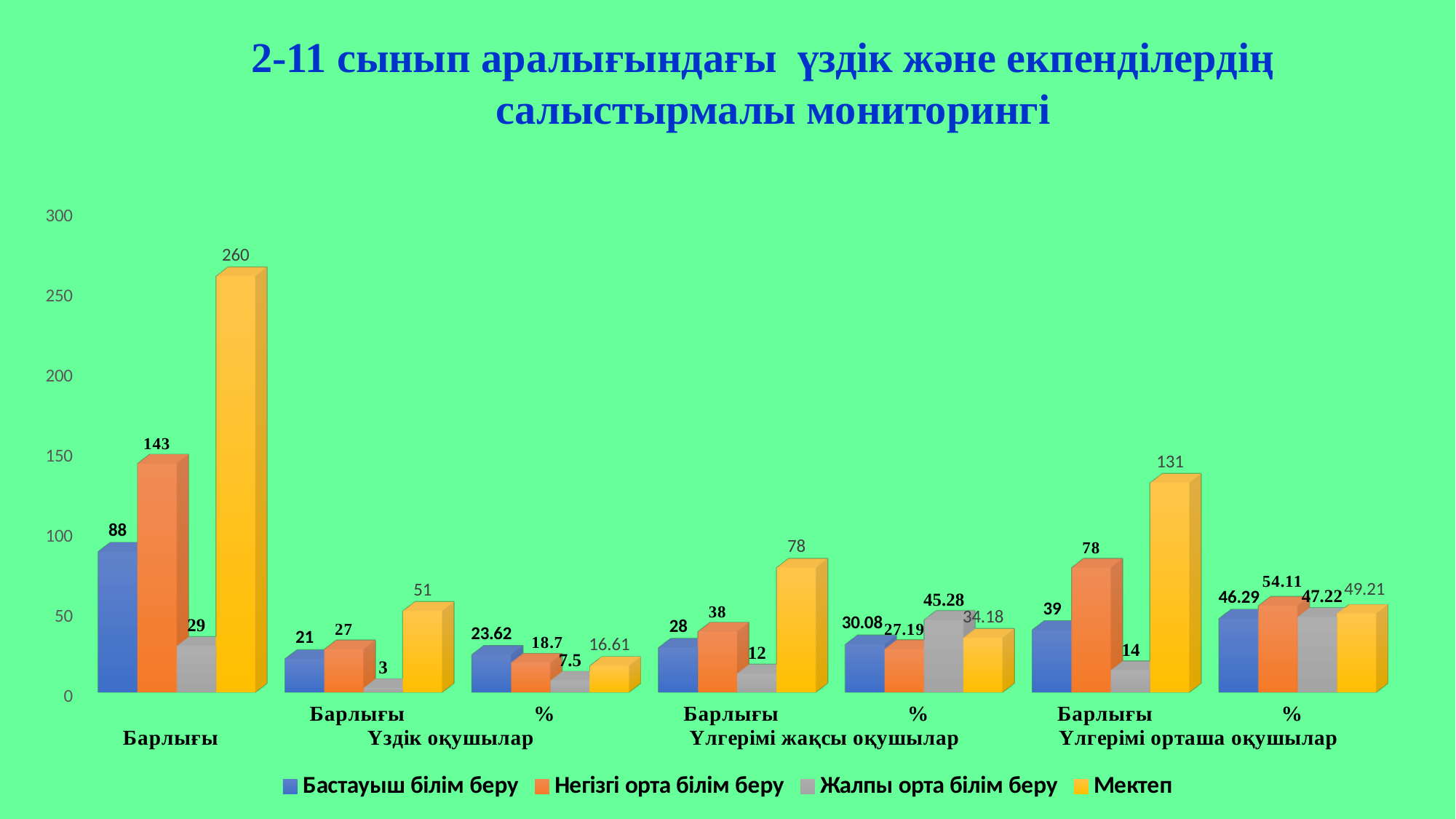
What is the value for Негізгі орта білім беру in the Барлығы category? 143 What is the value for Мектеп in the Барлығы category? 260 Which series has the lowest value in the % column under Үздік оқушылар? Жалпы орта білім беру What is the value for Мектеп in the Барлығы column under Үлгерімі орташа оқушылар? 131 What kind of chart is shown on the slide? Bar chart How many series does the legend list? 4 Which is larger: the Бастауыш білім беру value or the Негізгі орта білім беру value in the % column under Үлгерімі орташа оқушылар? Негізгі орта білім беру What is the value for Жалпы орта білім беру in the % column under Үлгерімі жақсы оқушылар? 45.28 What is the value for Жалпы орта білім беру in the Барлығы column under Үздік оқушылар? 3 Which series has the highest value in the Барлығы category? Мектеп What is the difference between the Мектеп value and the Негізгі орта білім беру value in the Барлығы category? 117 What is the value for Бастауыш білім беру in the % column under Үздік оқушылар? 23.62